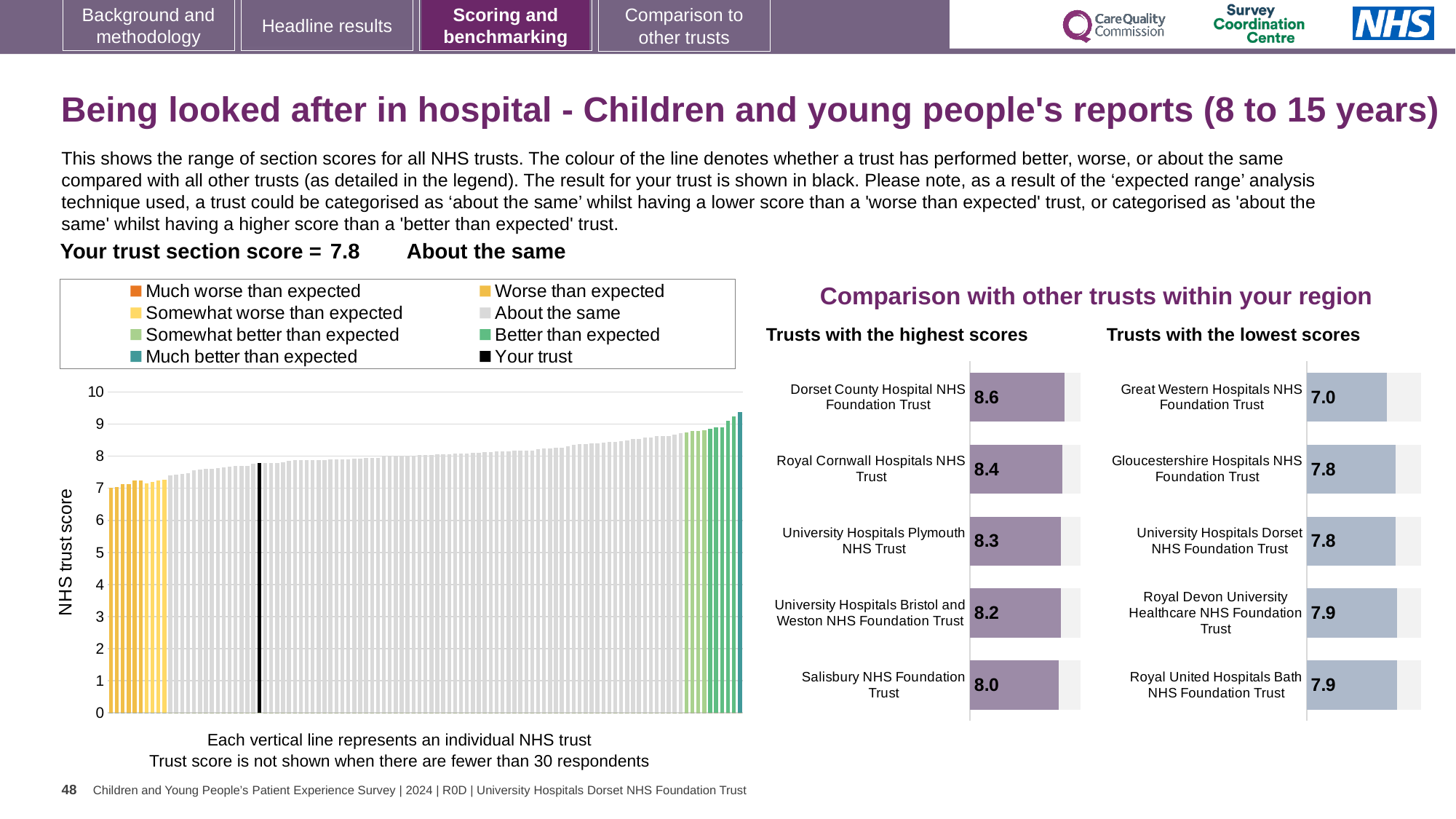
In the 'Trusts with the highest scores' chart, what is the score for Dorset County Hospital NHS Foundation Trust? 8.6 In the large chart on the left, do the trust scores rise or fall from left to right? rise In the large chart on the left, what is the section score for your trust (the black bar)? 7.8 In the 'Trusts with the highest scores' chart, what is the difference between the scores of Dorset County Hospital NHS Foundation Trust and Salisbury NHS Foundation Trust? 0.6 In the 'Trusts with the lowest scores' chart, how many trusts are shown? 5 In the 'Trusts with the highest scores' chart, which trust has the lowest score? Salisbury NHS Foundation Trust In the 'Trusts with the lowest scores' chart, which has the higher score: Great Western Hospitals NHS Foundation Trust or Royal Devon University Healthcare NHS Foundation Trust? Royal Devon University Healthcare NHS Foundation Trust In the 'Trusts with the lowest scores' chart, what is the score for Great Western Hospitals NHS Foundation Trust? 7.0 How many entries does the legend above the large chart on the left list? 8 In the 'Trusts with the lowest scores' chart, what is the score for University Hospitals Dorset NHS Foundation Trust? 7.8 In the 'Trusts with the highest scores' chart, what is the score for Royal Cornwall Hospitals NHS Trust? 8.4 What kind of chart is the large chart on the left showing NHS trust scores? bar chart